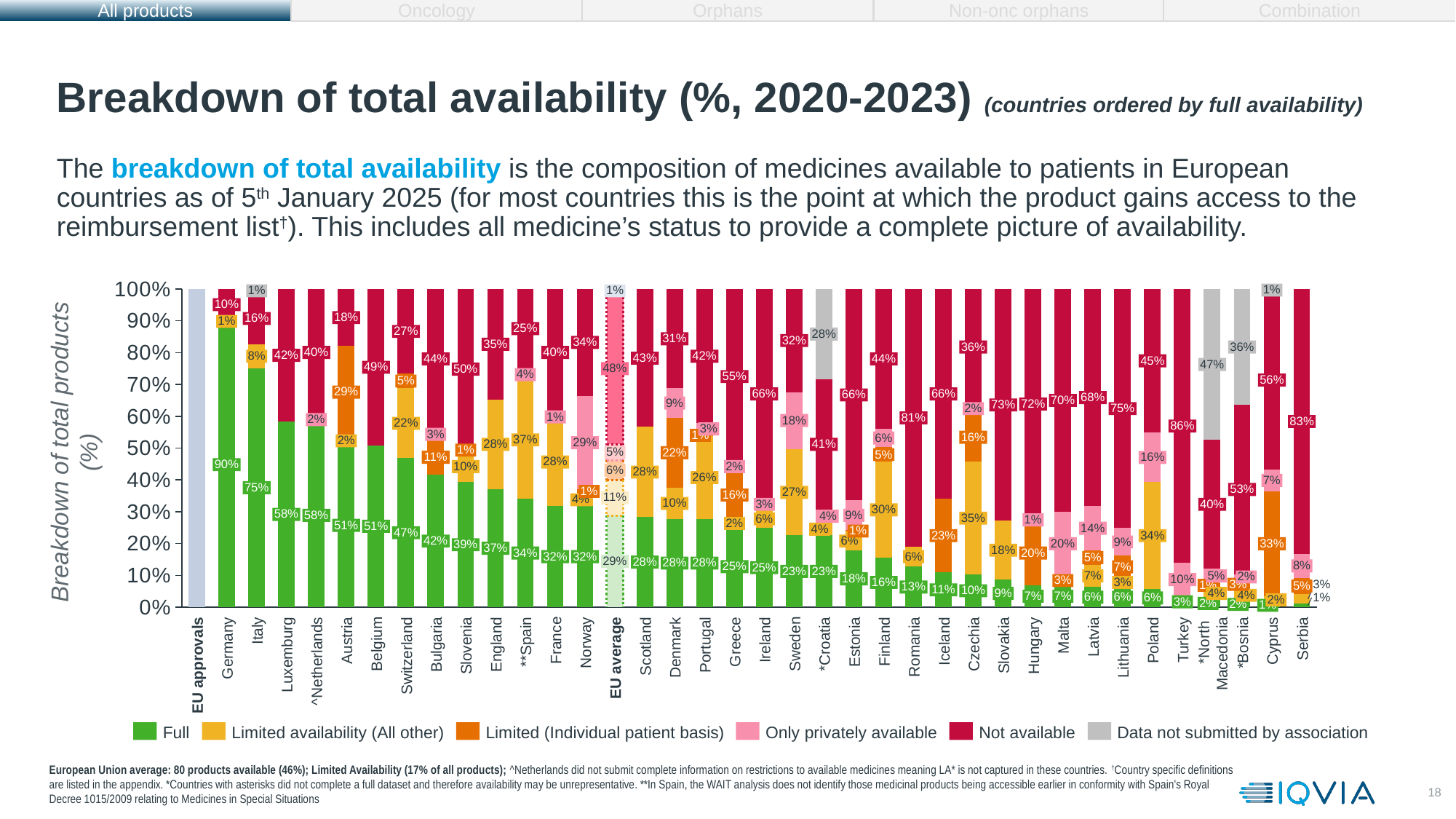
What kind of chart is shown? Stacked bar chart What is the Not available share for Romania? 81% What is the Only privately available value for Norway? 29% Which has a larger Not available share, Luxemburg or ^Netherlands? Luxemburg How many bars are shown on the x axis, including EU approvals and EU average? 38 What is the difference between the Full availability of Germany and Italy? 15% What is the Full availability value for Germany? 90% Which country has the highest Not available share? Turkey Which country has the highest Full availability? Germany How many series does the legend list? 6 What is the Data not submitted by association value for *North Macedonia? 47% Does the Full availability share rise or fall moving from left to right along the x axis? Fall